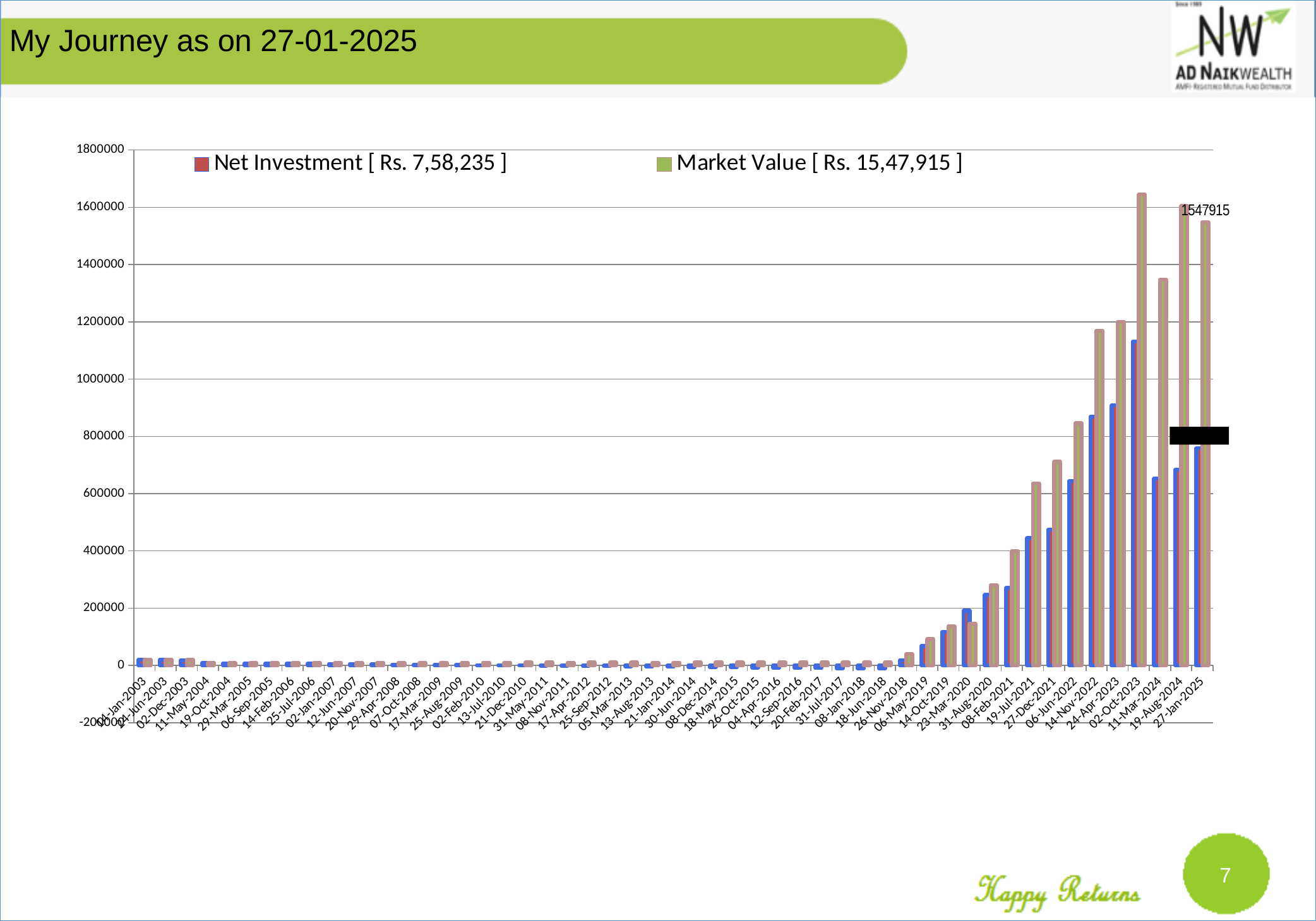
Is the Market Value for 02-Oct-2023 greater or less than 1400000? greater Is the Market Value for 11-Mar-2024 greater or less than 1200000? greater What is the title of the slide containing the chart? My Journey as on 27-01-2025 What is the Market Value for 27-Jan-2025 according to the data label on the chart? 1547915 What kind of chart is shown on the slide? bar chart For 23-Mar-2020, which is larger: Net Investment or Market Value? Net Investment What are the two series named in the chart legend? Net Investment [ Rs. 7,58,235 ] and Market Value [ Rs. 15,47,915 ] Is the Market Value for 14-Nov-2022 greater or less than 1000000? greater For 27-Jan-2025, which is larger: Net Investment or Market Value? Market Value Do the Market Value bars generally rise or fall from 26-Nov-2018 to 02-Oct-2023? rise How many series does the chart legend list? 2